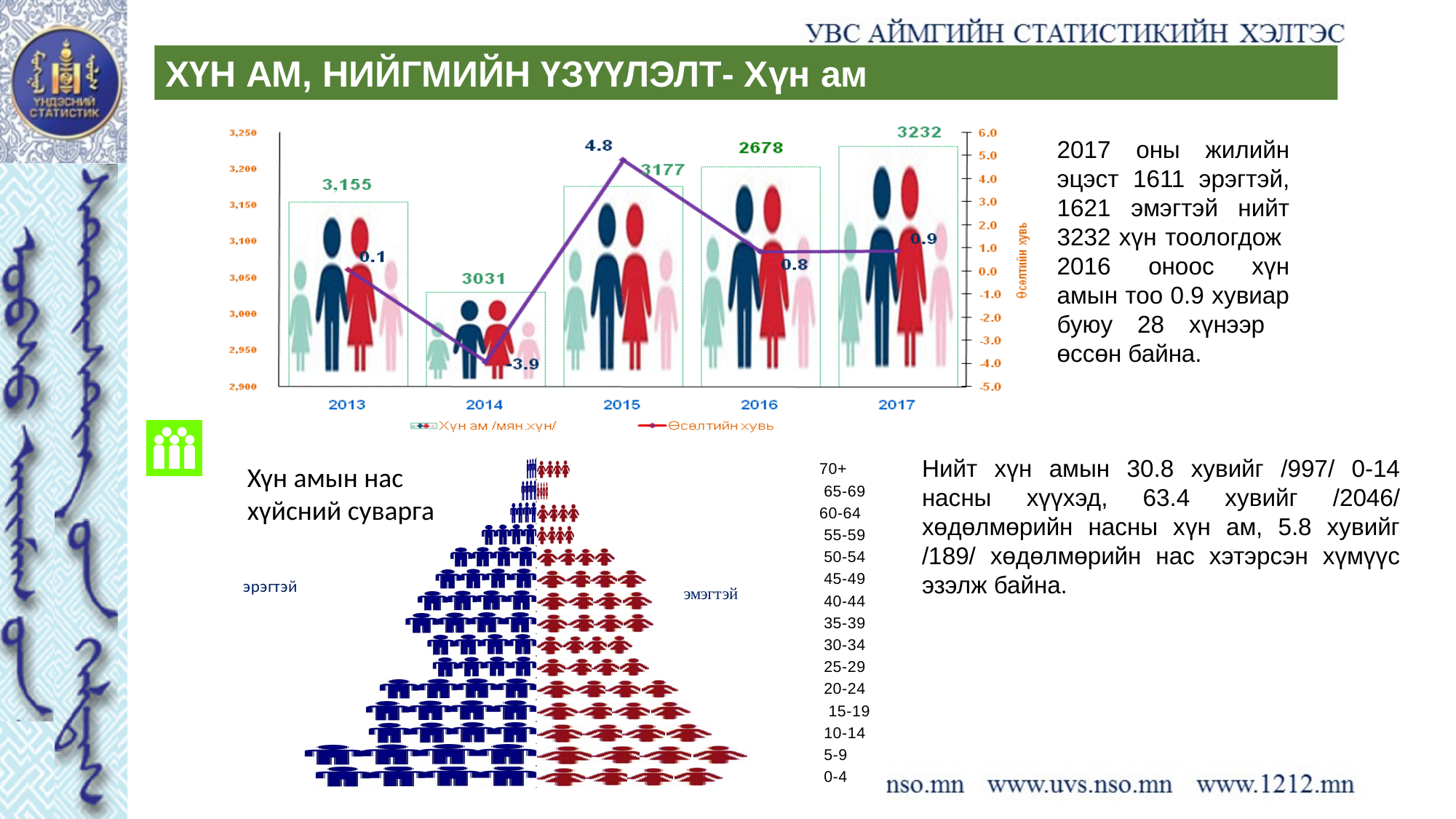
In the bottom population pyramid chart, how many age groups are listed? 15 In the top chart, what is the growth rate (Өсөлтийн хувь) labelled for 2014? -3.9 In the top chart, what is the population value labelled for 2015? 3177 In the top chart, does the growth rate line rise or fall from 2015 to 2016? fall In the top chart, which year has the lowest growth rate? 2014 In the top chart, how many years are shown on the x axis? 5 In the top chart, what is the growth rate labelled for 2013? 0.1 In the top chart, how many series does the legend list? 2 In the top chart, which year has the highest growth rate? 2015 In the top chart, what is the difference between the population labelled for 2017 and for 2013? 77 In the top chart, is the growth rate higher in 2016 or in 2017? 2017 In the top chart, what is the population value labelled for 2017? 3232